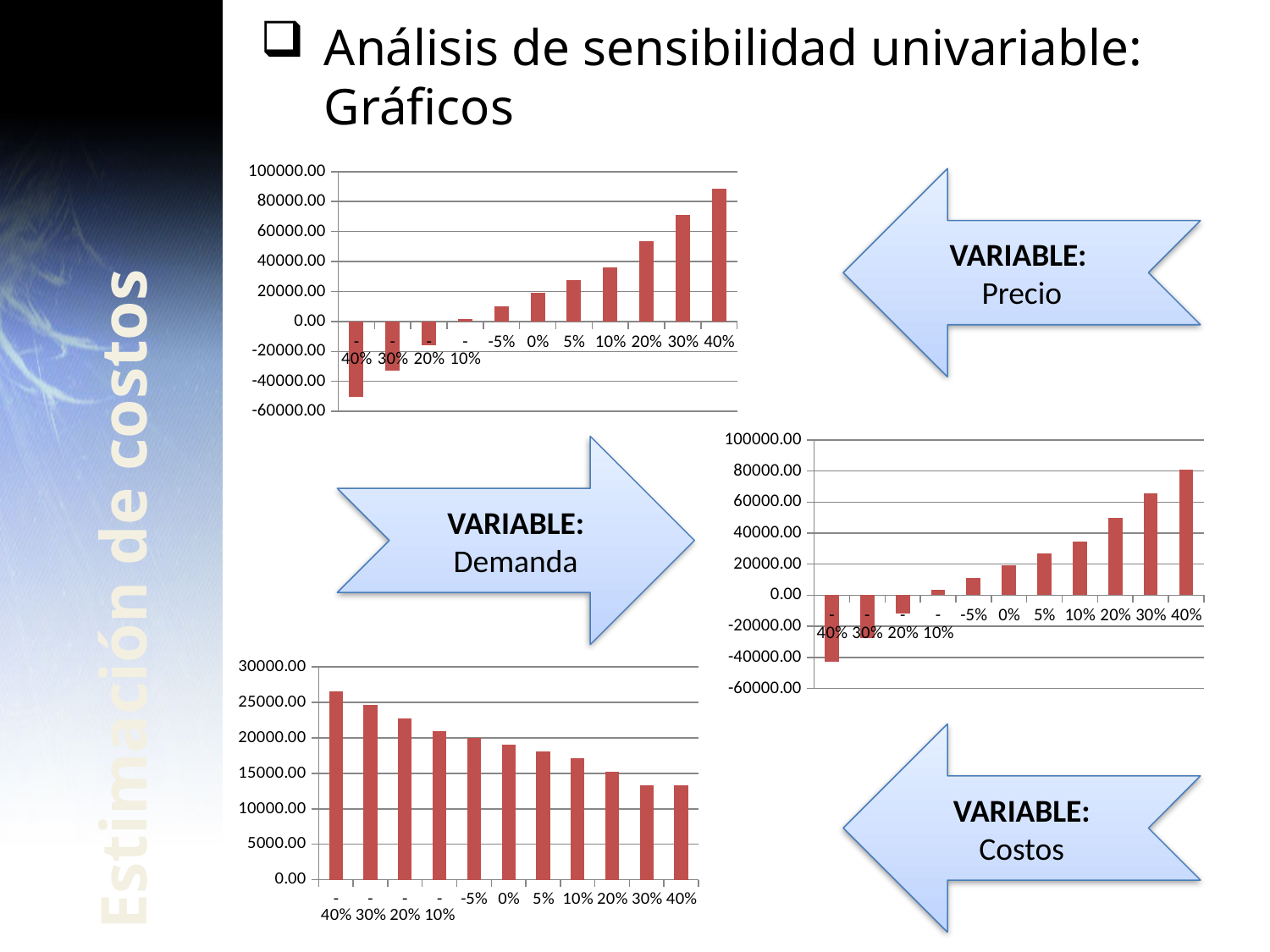
In the bottom-left chart, is the value for 0% greater or less than 15000.00? greater In the top-left chart, which category has the lowest value? -40% In the top-left chart, is the value for 40% greater or less than 80000.00? greater In the right-hand chart, is the value for 20% greater or less than 40000.00? greater What kind of chart is the top-left chart on the slide? bar chart In the top-left chart, which category has the highest value? 40% In the bottom-left chart, do the values rise or fall as you move from -40% to 40% along the x axis? fall In the right-hand chart, do the values rise or fall as you move from -40% to 40% along the x axis? rise How many categories are shown on the x axis of the bottom-left chart? 11 In the bottom-left chart, which category has the highest value? -40%